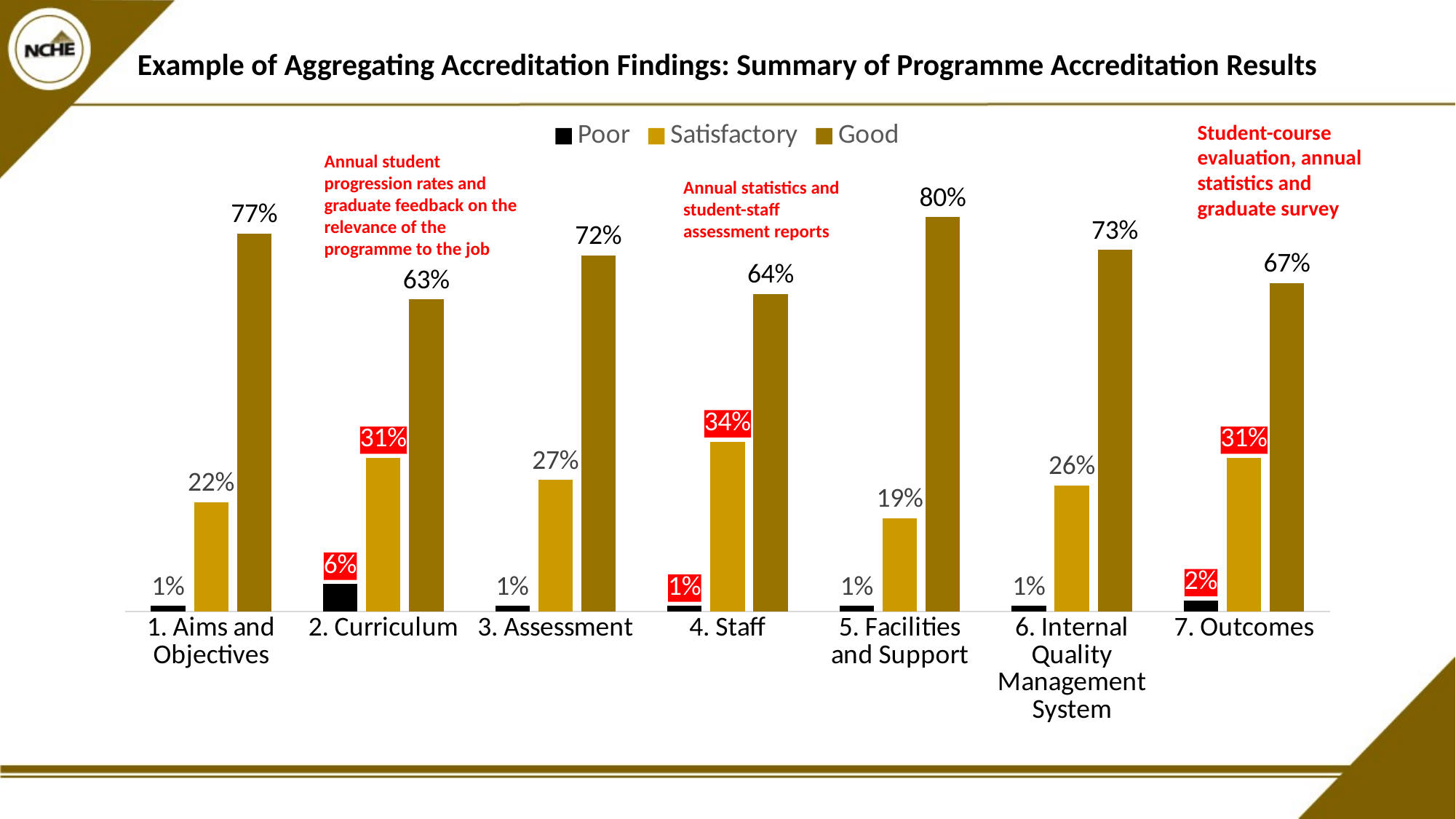
Which category has the highest Poor value? 2. Curriculum What is the Poor value for 7. Outcomes? 2% How many series does the legend list? 3 Which category has the highest Good value? 5. Facilities and Support How many categories are shown on the x axis? 7 Which is larger, the Satisfactory value for 6. Internal Quality Management System or for 5. Facilities and Support? 6. Internal Quality Management System What kind of chart is shown on the slide? Bar chart What is the Good value for 5. Facilities and Support? 80% What is the difference between the Good values for 1. Aims and Objectives and 3. Assessment? 5% What is the Satisfactory value for 2. Curriculum? 31% Which category has the lowest Good value? 2. Curriculum Which category has the highest Satisfactory value? 4. Staff